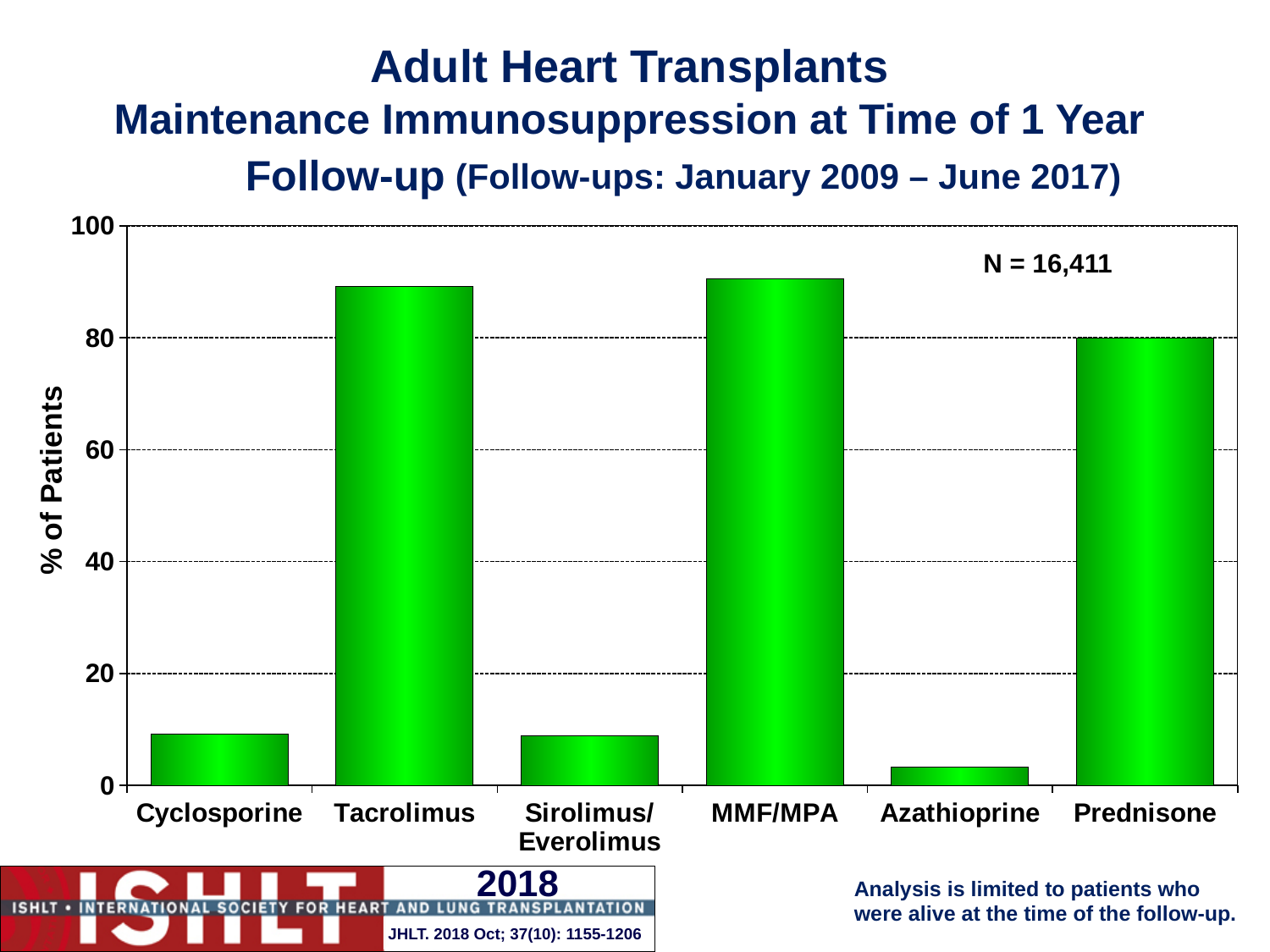
Is the value for MMF/MPA greater or less than 80? greater Which has a higher % of patients, Tacrolimus or Cyclosporine? Tacrolimus Which category has the lowest % of patients? Azathioprine Is the value for Sirolimus/Everolimus greater or less than 20? less Which has a higher % of patients, Prednisone or Azathioprine? Prednisone Is the value for Azathioprine greater or less than 20? less How many categories are shown on the x axis of the chart? 6 What kind of chart is shown on the slide? bar chart What is the label of the y axis? % of Patients